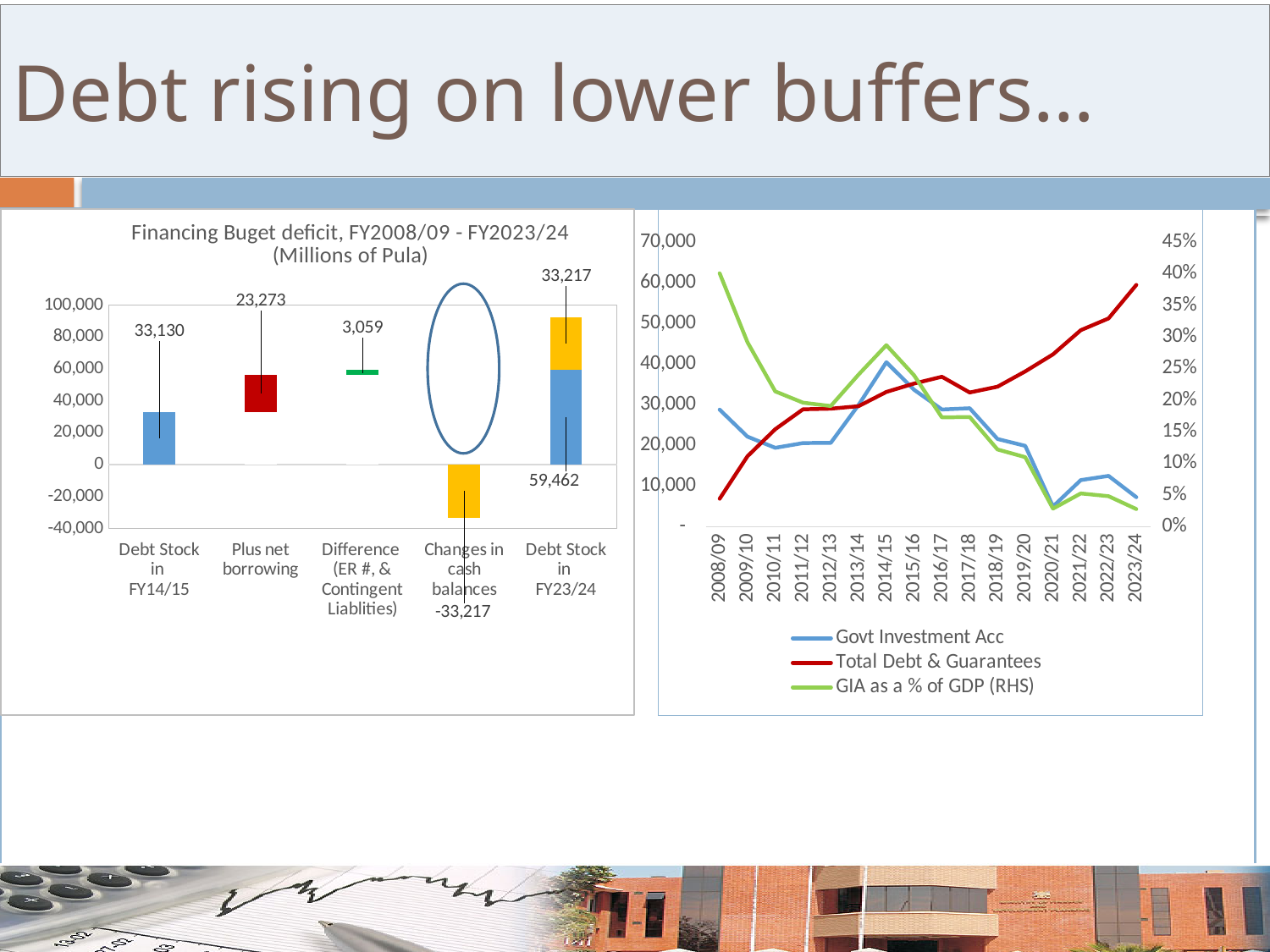
In the left chart, what is the value labelled for Plus net borrowing? 23,273 In the left chart, which is larger: Plus net borrowing or Difference (ER #, & Contingent Liabilities)? Plus net borrowing In the left chart, what is the value labelled for Changes in cash balances? -33,217 In the right chart, does the Total Debt & Guarantees line generally rise or fall from 2008/09 to 2023/24? rise How many categories are shown on the x axis of the left chart? 5 In the left chart, what is the value labelled for Difference (ER #, & Contingent Liabilities)? 3,059 How many series does the legend of the right chart list? 3 What kind of chart is the right chart? line chart In the left chart, what is the total of the two labelled segments of the Debt Stock in FY23/24 bar? 92,679 In the left chart, what is the difference between the Debt Stock in FY14/15 value and the Plus net borrowing value? 9,857 In the right chart, is the value for Total Debt & Guarantees in 2023/24 greater or less than 50,000? greater In the left chart, what is the value labelled for Debt Stock in FY14/15? 33,130